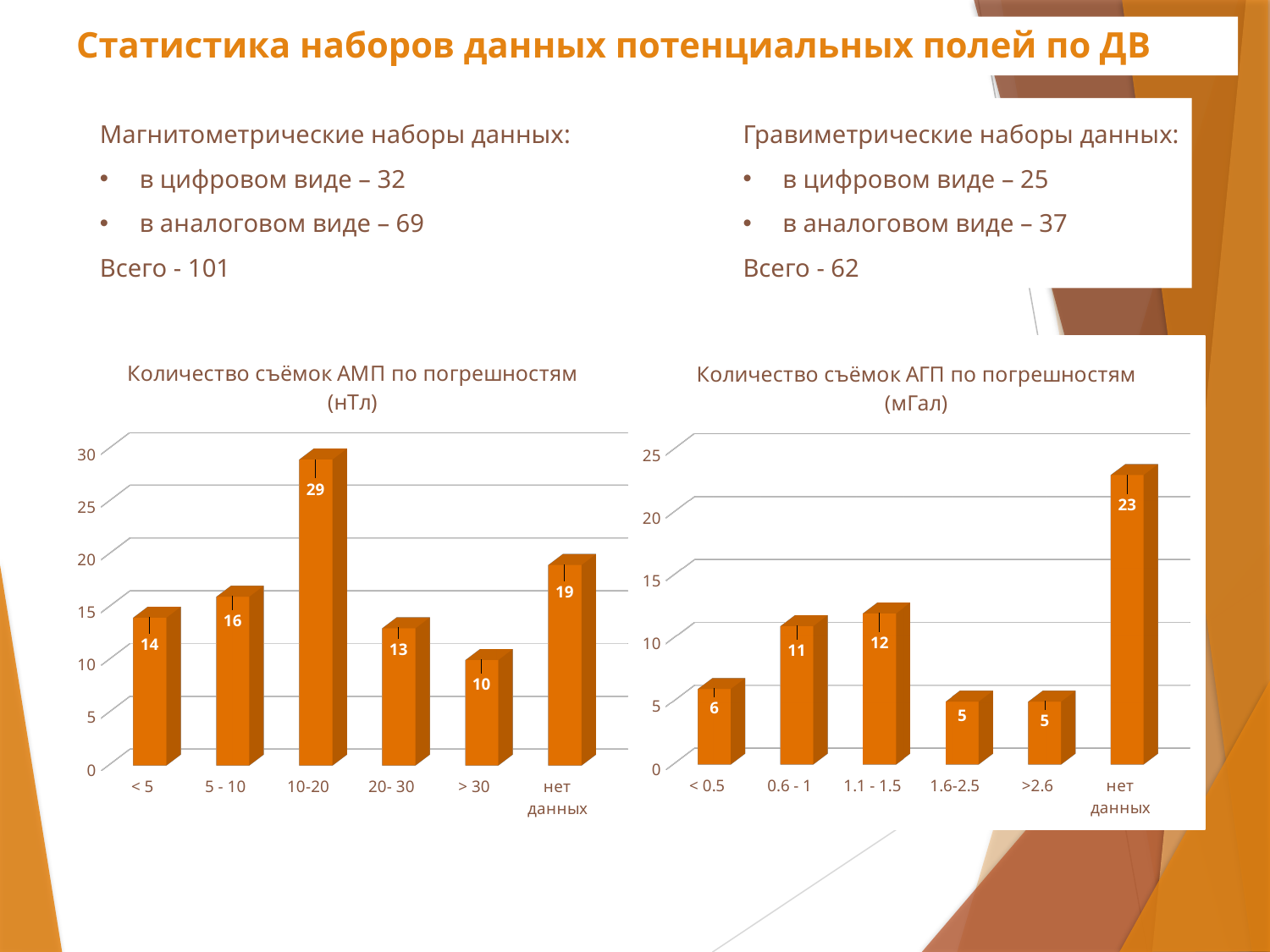
In the chart 'Количество съёмок АМП по погрешностям (нТл)', what is the value for the '10-20' category? 29 In the chart 'Количество съёмок АГП по погрешностям (мГал)', what is the value for the 'нет данных' category? 23 In the chart 'Количество съёмок АМП по погрешностям (нТл)', which category has the lowest value? > 30 In the chart 'Количество съёмок АГП по погрешностям (мГал)', what is the difference between the '1.1 - 1.5' and '0.6 - 1' values? 1 In the chart 'Количество съёмок АМП по погрешностям (нТл)', what is the value for the 'нет данных' category? 19 In the chart 'Количество съёмок АГП по погрешностям (мГал)', is the value for 'нет данных' greater or less than 20? greater In the chart 'Количество съёмок АМП по погрешностям (нТл)', which is larger: the value for '5 - 10' or the value for '20- 30'? 5 - 10 In the chart 'Количество съёмок АГП по погрешностям (мГал)', what is the value for the '< 0.5' category? 6 In the chart 'Количество съёмок АГП по погрешностям (мГал)', which category has the highest value? нет данных In the chart 'Количество съёмок АМП по погрешностям (нТл)', how many categories are shown on the x axis? 6 In the chart 'Количество съёмок АМП по погрешностям (нТл)', what is the difference between the '10-20' and '> 30' values? 19 What type of chart is 'Количество съёмок АМП по погрешностям (нТл)'? bar chart